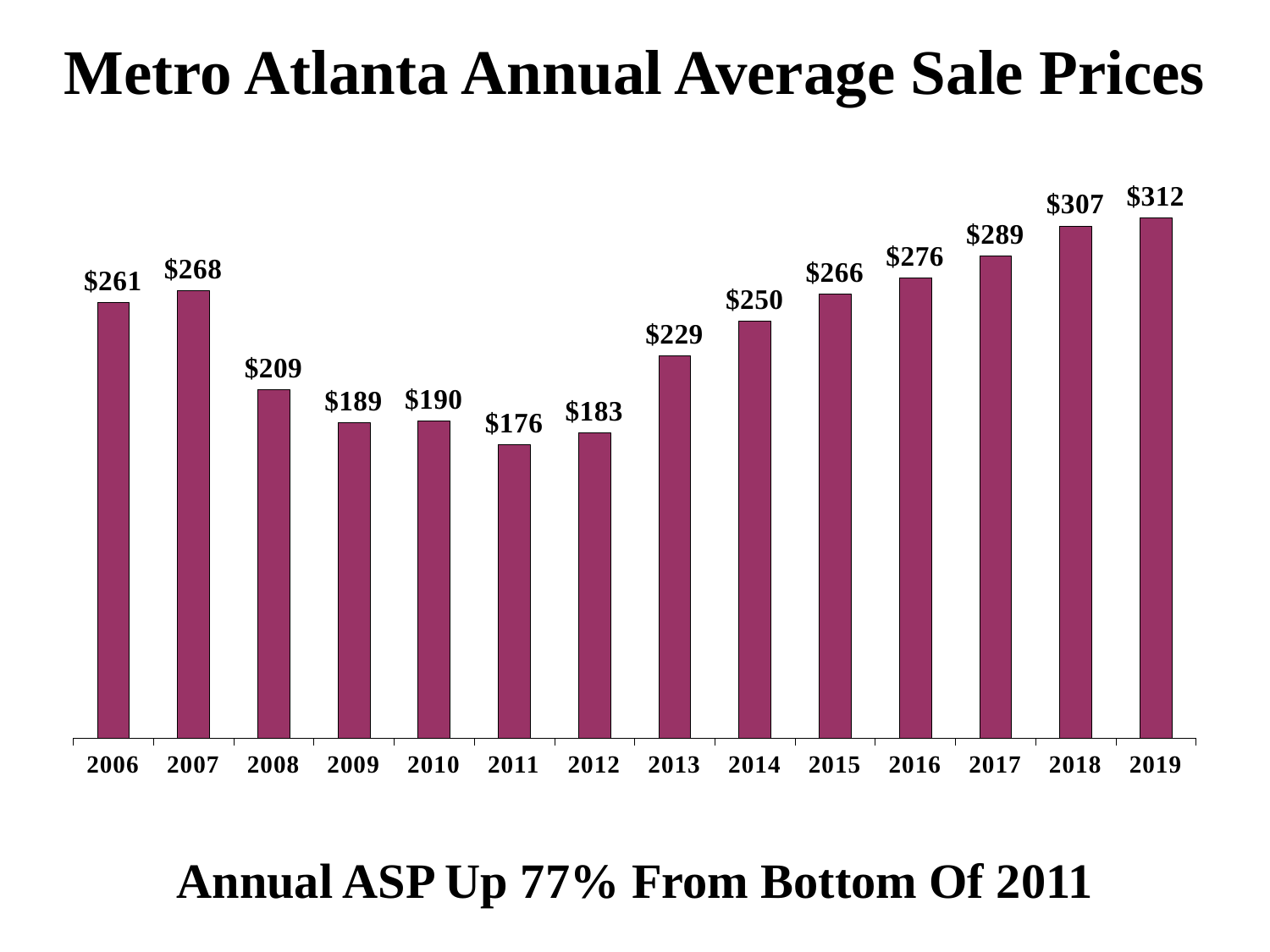
How many years are shown on the x axis? 14 What is the title of the chart? Metro Atlanta Annual Average Sale Prices What is the difference between the 2019 value and the 2011 value? $136 What is the average sale price shown for 2011? $176 Do the values rise or fall from 2011 to 2019? Rise What is the average sale price shown for 2019? $312 What is the average sale price shown for 2008? $209 Which year has the highest average sale price? 2019 What is the difference between the 2007 value and the 2006 value? $7 Which is larger, the value for 2013 or the value for 2008? 2013 Which year has the lowest average sale price? 2011 What kind of chart is shown on the slide? Bar chart